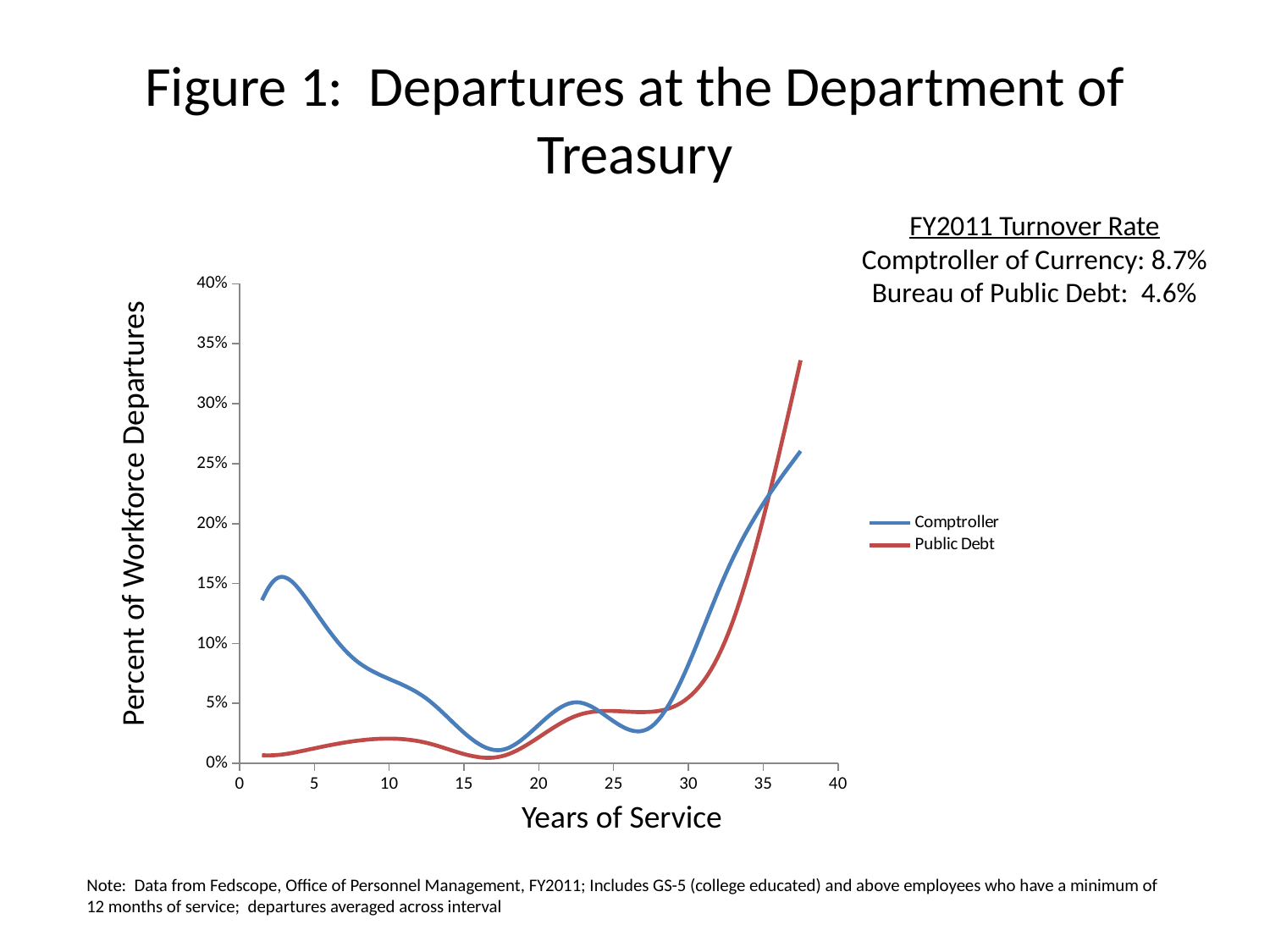
How many series does the legend list? 2 What kind of chart is shown on the slide? line chart Is the Comptroller value at 5 years of service greater or less than 10%? greater Is the Public Debt value at 10 years of service greater or less than 5%? less Does the Public Debt line rise or fall between 30 and 37 years of service? rise What are the two series named in the legend? Comptroller and Public Debt What is the title of the x axis? Years of Service Does the Comptroller line rise or fall between 3 and 17 years of service? fall Is the Comptroller value at 35 years of service greater or less than 20%? greater At 5 years of service, which series has the higher departure rate, Comptroller or Public Debt? Comptroller At the right end of the chart (about 37 years of service), which series has the higher departure rate? Public Debt